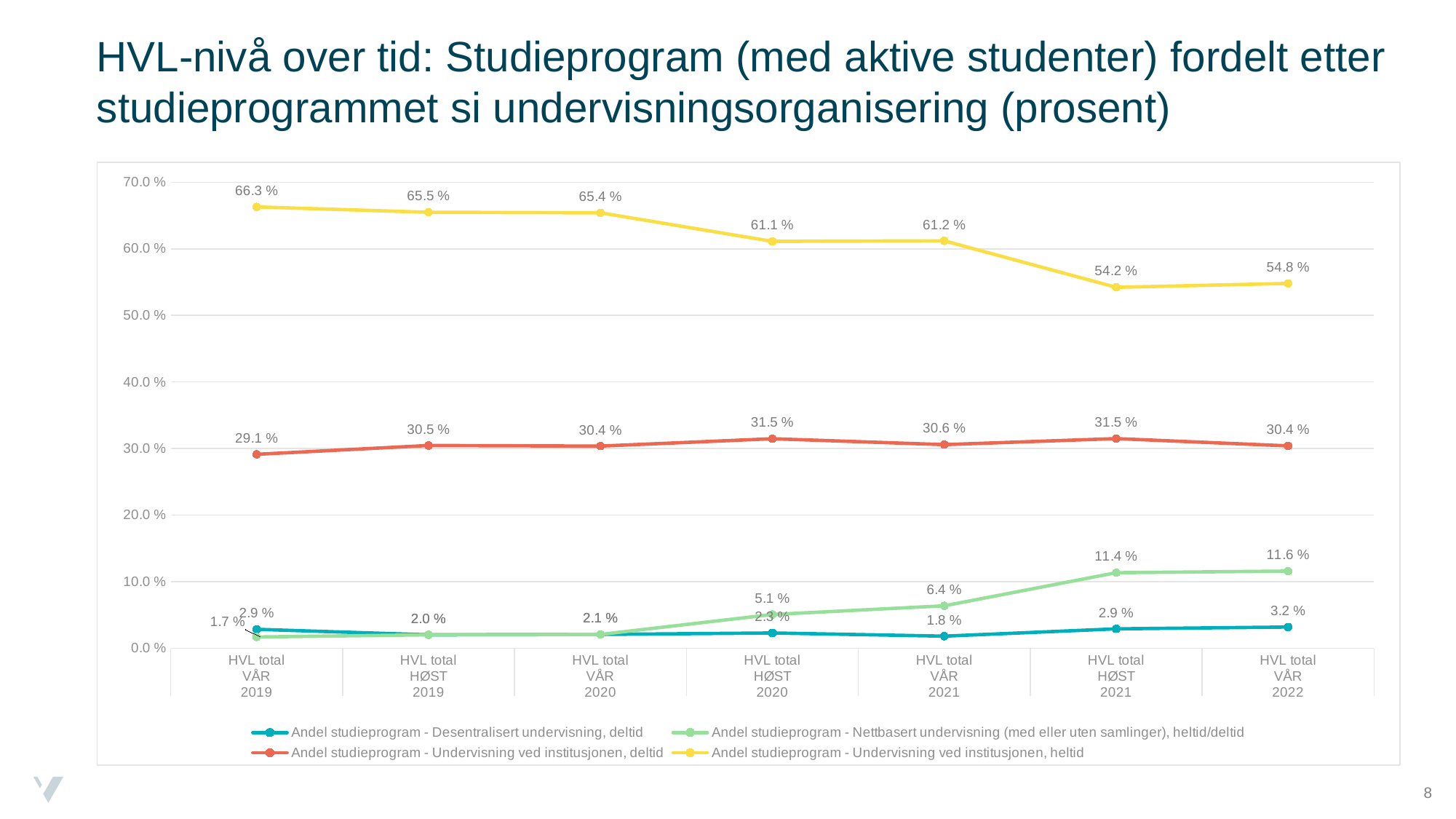
What kind of chart is shown on the slide? Line chart At HVL total VÅR 2022, which is larger: the share for Nettbasert undervisning or the share for Desentralisert undervisning, deltid? Nettbasert undervisning In which period is 'Andel studieprogram - Undervisning ved institusjonen, heltid' at its lowest? HVL total HØST 2021 What is the value for 'Andel studieprogram - Undervisning ved institusjonen, heltid' at HVL total VÅR 2019? 66.3 % Does the share for 'Andel studieprogram - Nettbasert undervisning (med eller uten samlinger), heltid/deltid' rise or fall from HVL total VÅR 2019 to HVL total VÅR 2022? Rise In which period is 'Andel studieprogram - Undervisning ved institusjonen, heltid' at its highest? HVL total VÅR 2019 What is the value for 'Andel studieprogram - Undervisning ved institusjonen, deltid' at HVL total HØST 2020? 31.5 % What is the value for 'Andel studieprogram - Nettbasert undervisning (med eller uten samlinger), heltid/deltid' at HVL total HØST 2021? 11.4 % How many time periods are shown on the x axis? 7 How many series does the legend list? 4 What is the value for 'Andel studieprogram - Desentralisert undervisning, deltid' at HVL total VÅR 2021? 1.8 % By how many percentage points did 'Andel studieprogram - Undervisning ved institusjonen, heltid' fall from HVL total VÅR 2019 to HVL total VÅR 2022? 11.5 percentage points